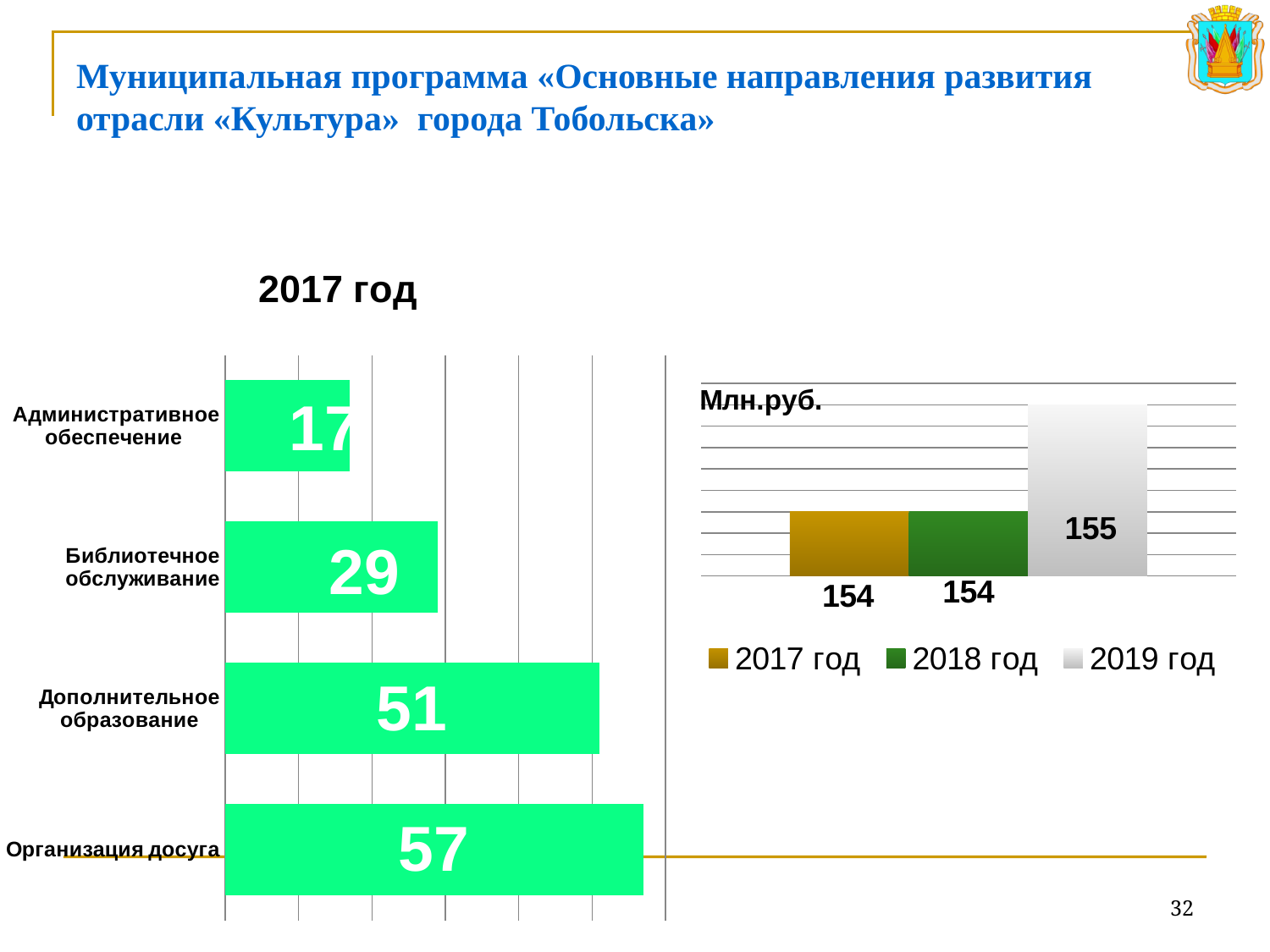
In the chart titled "2017 год", which category has the lowest value? Административное обеспечение How many categories are shown in the chart titled "2017 год"? 4 In the chart titled "2017 год", what is the value for Административное обеспечение? 17 What kind of chart is the chart titled "2017 год"? bar chart In the chart titled "2017 год", which category has the highest value? Организация досуга In the chart titled "2017 год", what is the difference between the values for Организация досуга and Дополнительное образование? 6 In the chart on the right labelled "Млн.руб.", what is the difference between the values for 2019 год and 2017 год? 1 In the chart titled "2017 год", which is larger: Библиотечное обслуживание or Дополнительное образование? Дополнительное образование In the chart on the right labelled "Млн.руб.", what is the value for 2019 год? 155 How many series does the legend list in the chart on the right labelled "Млн.руб."? 3 In the chart titled "2017 год", what is the value for Организация досуга? 57 In the chart titled "2017 год", what is the value for Библиотечное обслуживание? 29